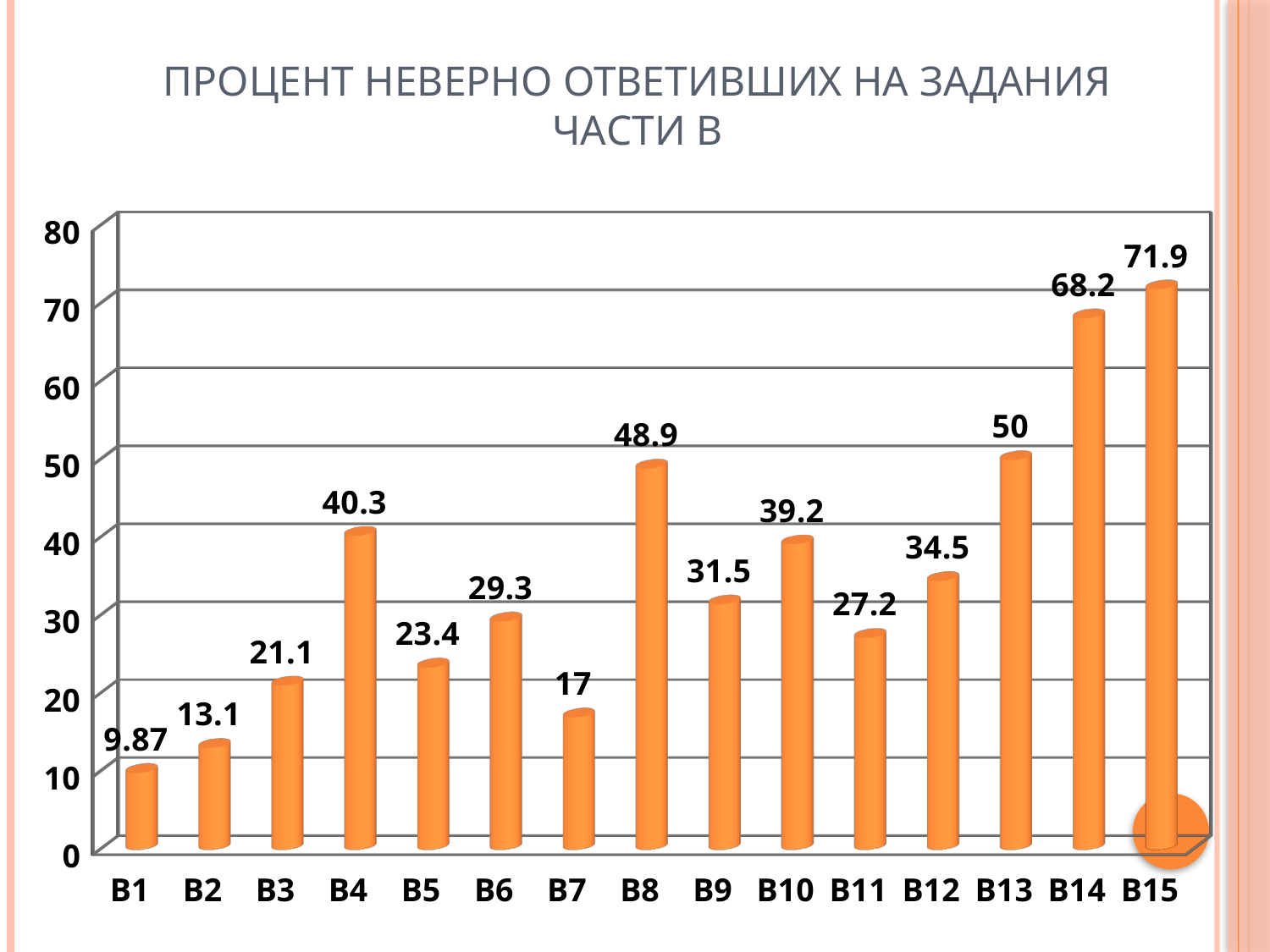
Is the value for B13 greater or less than 40? greater Which is larger, the value for B10 or the value for B12? B10 What is the title of the chart? Процент неверно ответивших на задания части В What is the value for B11? 27.2 What is the difference between the values for B15 and B14? 3.7 What is the value for B4? 40.3 What kind of chart is shown on the slide? bar chart Which category has the lowest value? B1 What is the difference between the values for B8 and B7? 31.9 What is the value for B1? 9.87 Which category has the highest value? B15 How many categories are shown on the x axis? 15